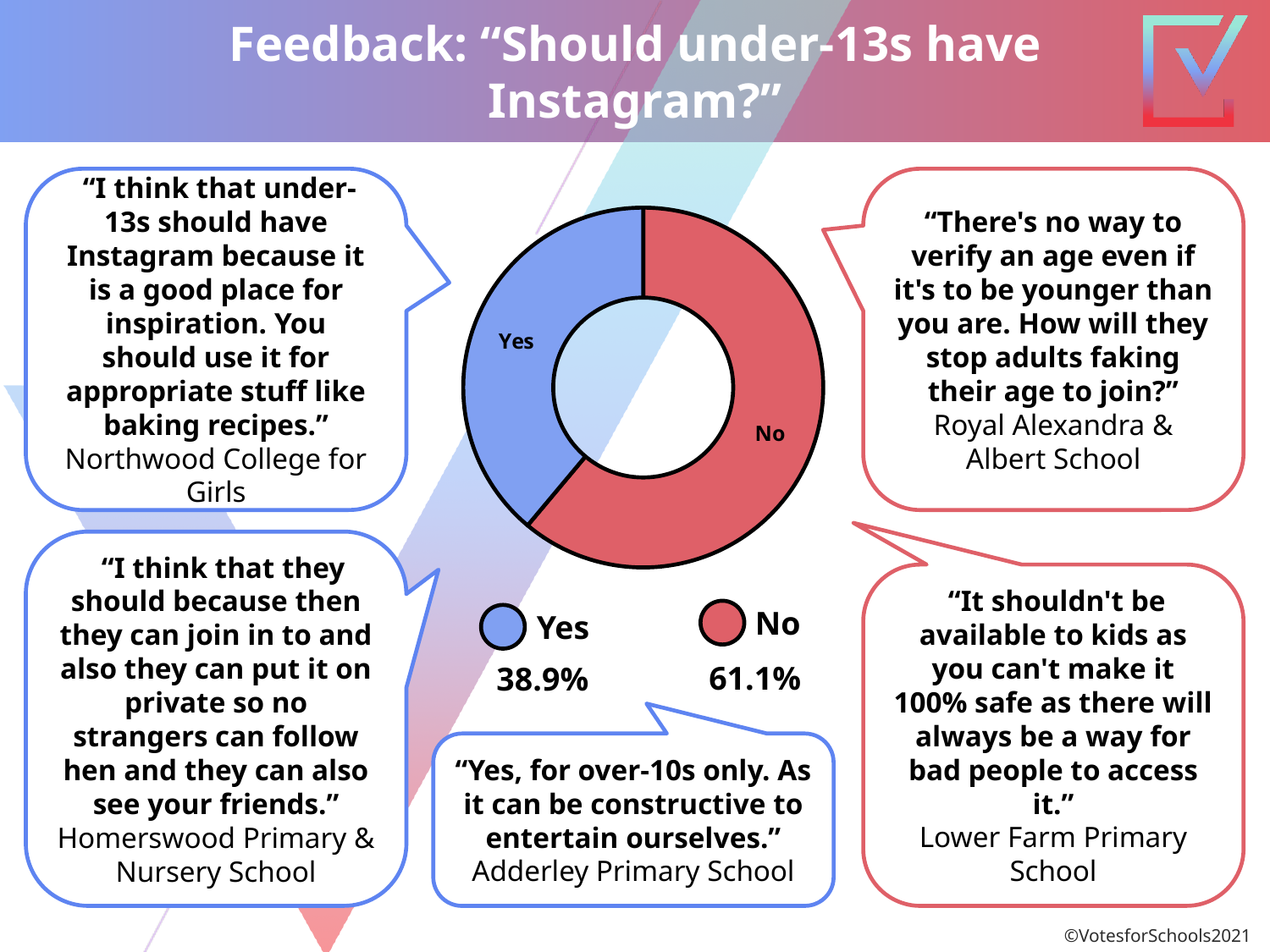
What percentage of respondents answered "Yes" in the chart? 38.9% Which response has the smallest share of the chart? Yes What share of the chart does the "No" slice represent? 61.1% What colour is used for the "No" slice in the chart? red Which response is larger, "Yes" or "No"? No What is the difference in percentage points between the "No" and "Yes" responses? 22.2 percentage points How many categories are shown in the chart? 2 What colour is used for the "Yes" slice in the chart? blue What kind of chart is shown on the slide? doughnut chart Does the "Yes" response account for more or less than half of the chart? less Which response has the largest share of the chart? No What percentage of respondents answered "No" in the chart? 61.1%